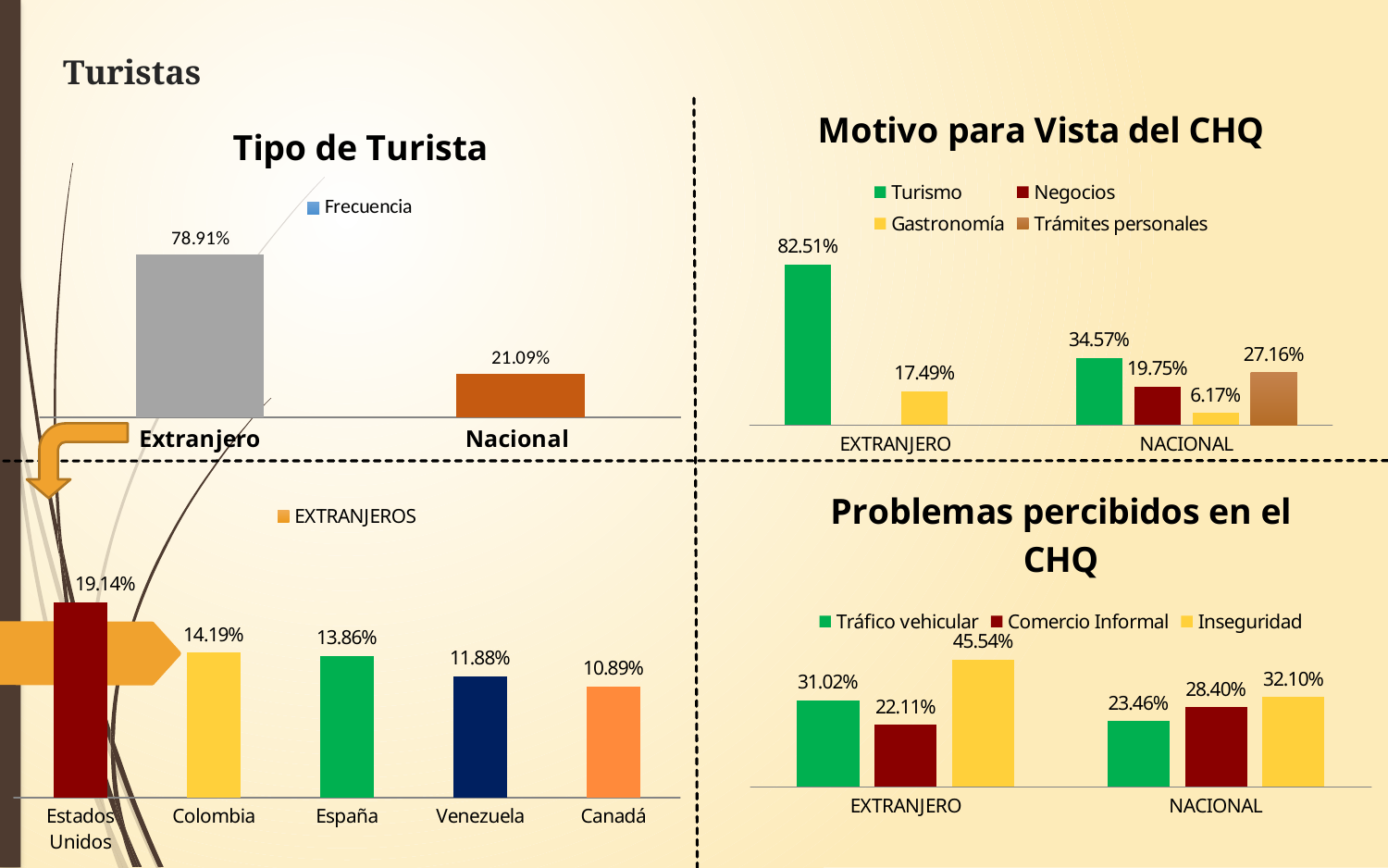
In the 'Problemas percibidos en el CHQ' chart, which is larger: Tráfico vehicular for EXTRANJERO or Tráfico vehicular for NACIONAL? EXTRANJERO In the bottom-left chart with the legend 'EXTRANJEROS', which country has the highest value? Estados Unidos In the 'Problemas percibidos en el CHQ' chart, what is the value for Inseguridad in the EXTRANJERO group? 45.54% In the 'Tipo de Turista' chart, what kind of chart is shown? Bar chart In the 'Tipo de Turista' chart, what is the difference between the Extranjero and Nacional values? 57.82% In the bottom-left chart with the legend 'EXTRANJEROS', what is the value for Venezuela? 11.88% In the 'Tipo de Turista' chart, what is the value for Extranjero? 78.91% In the bottom-left chart with the legend 'EXTRANJEROS', do the values rise or fall from Estados Unidos to Canadá? Fall In the 'Motivo para Vista del CHQ' chart, how many series does the legend list? 4 In the 'Motivo para Vista del CHQ' chart, what is the value for Turismo in the EXTRANJERO group? 82.51% In the 'Motivo para Vista del CHQ' chart, which series has the lowest value in the NACIONAL group? Gastronomía In the bottom-left chart with the legend 'EXTRANJEROS', how many countries are shown? 5